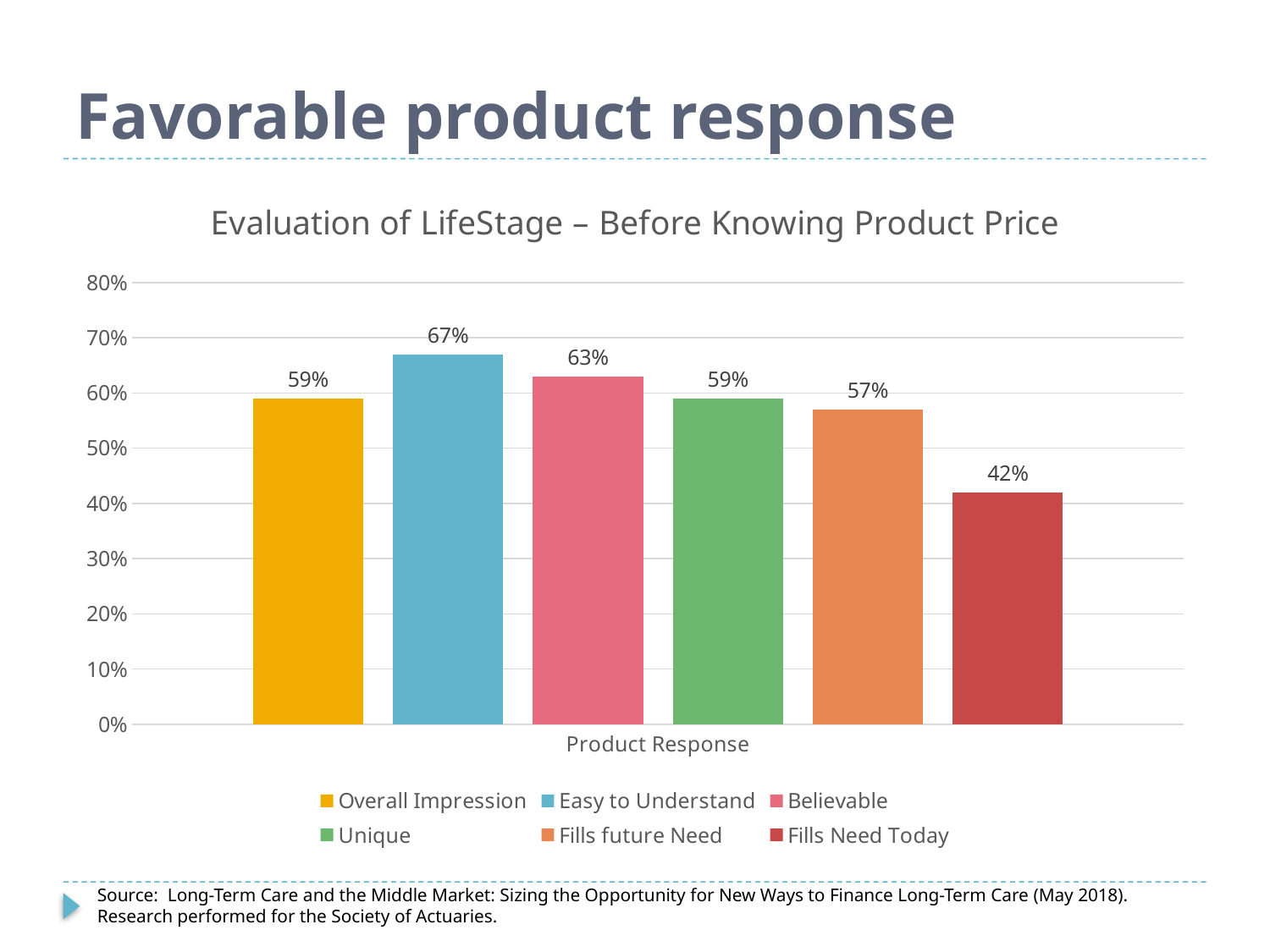
What is the value for Easy to Understand? 67% Which series has the lowest value? Fills Need Today Which series has the highest value? Easy to Understand What is the value for Fills future Need? 57% What is the difference between the values for Easy to Understand and Fills Need Today? 25% What is the title of the chart? Evaluation of LifeStage – Before Knowing Product Price What kind of chart is shown on the slide? Bar chart What is the difference between the values for Believable and Fills future Need? 6% Which is larger, the value for Believable or the value for Unique? Believable What is the value for Believable? 63% How many series does the legend list? 6 What is the value for Fills Need Today? 42%